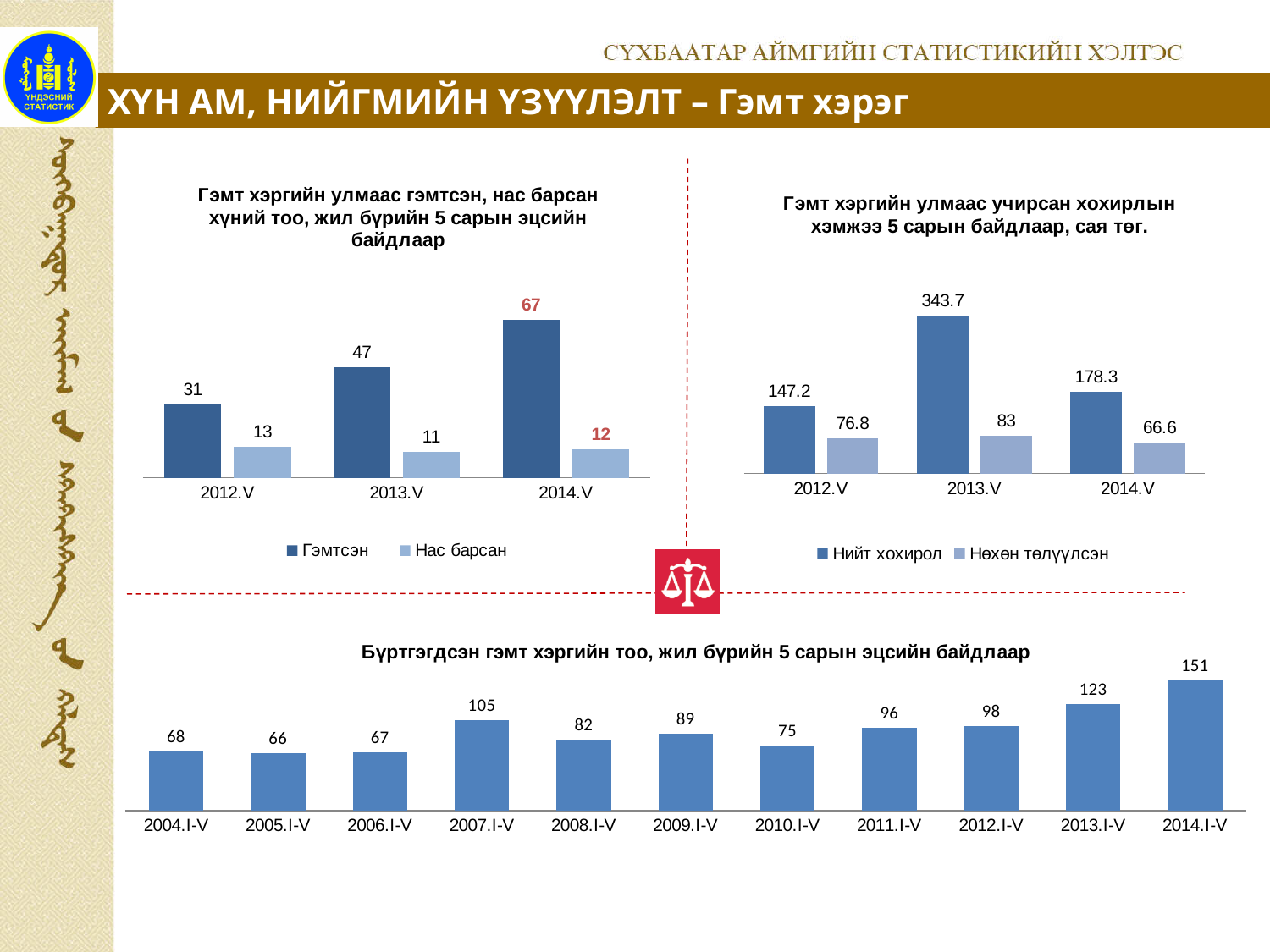
In the top-right chart, which year has the highest Нийт хохирол value? 2013.V In the bottom chart, what is the value for 2007.I-V? 105 In the top-right chart, what is the value for Нөхөн төлүүлсэн in 2014.V? 66.6 In the top-left chart, what is the difference between Гэмтсэн and Нас барсан in 2012.V? 18 In the top-right chart, what is the difference between Нийт хохирол and Нөхөн төлүүлсэн in 2012.V? 70.4 In the bottom chart, which period has the lowest value? 2005.I-V In the top-right chart, what is the value for Нийт хохирол in 2013.V? 343.7 What kind of chart is the bottom chart? Bar chart In the top-left chart, what is the value for Гэмтсэн in 2014.V? 67 In the top-left chart, what is the value for Нас барсан in 2013.V? 11 In the bottom chart, how many periods are shown on the x axis? 11 In the top-left chart, how many series does the legend list? 2